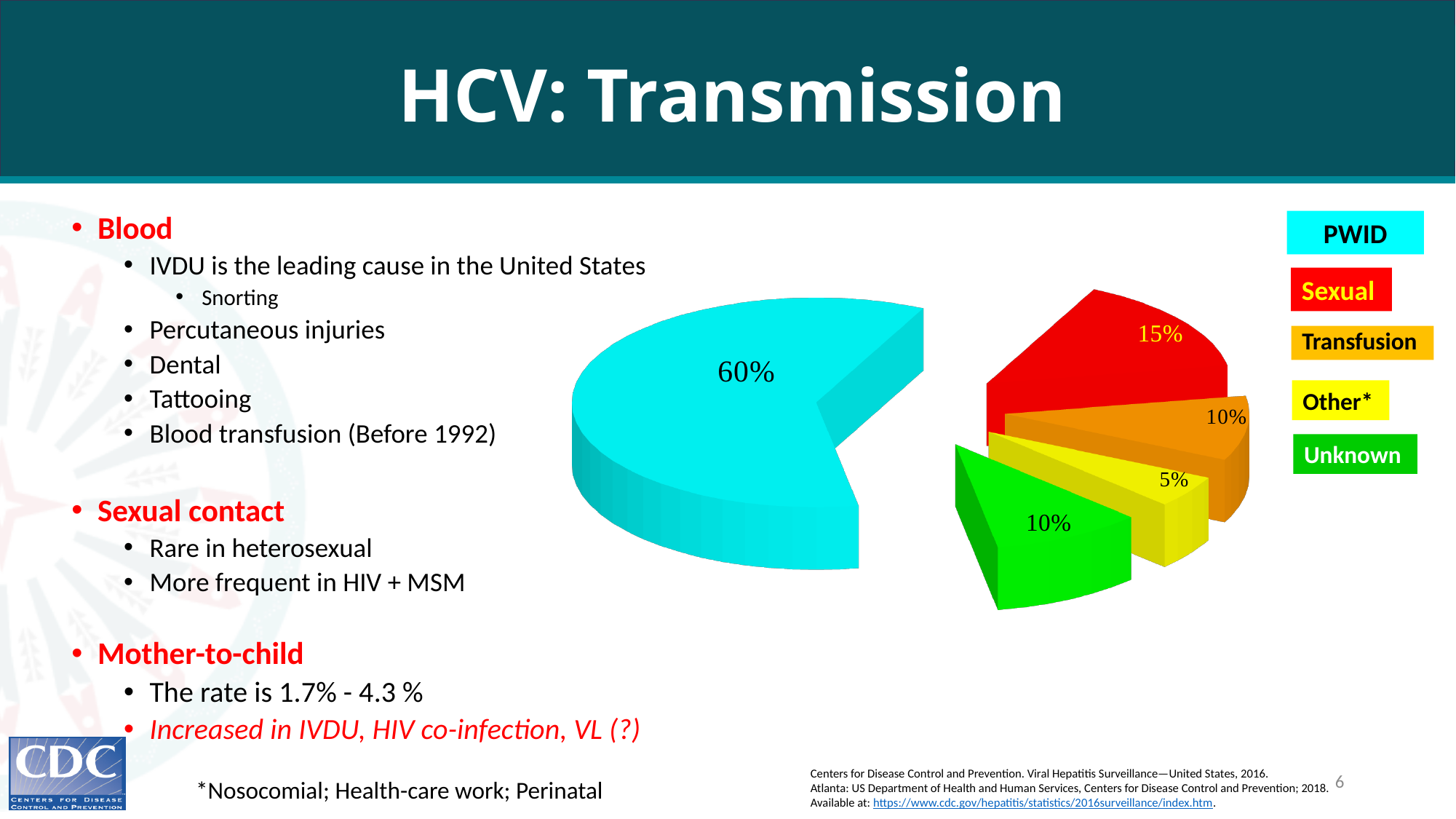
Which category has the largest slice of the pie? PWID What colour is the PWID slice in the pie chart? cyan Which is larger, the Sexual slice or the Transfusion slice? Sexual What share of the pie does the Unknown slice represent? 10% How many entries does the legend list? 5 How many slices does the pie chart have? 5 What share of the pie does the Other* slice represent? 5% Which category has the smallest slice of the pie? Other* What share of the pie does the Sexual slice represent? 15% What is the difference between the PWID share and the Sexual share? 45% What kind of chart is shown on the slide? pie chart